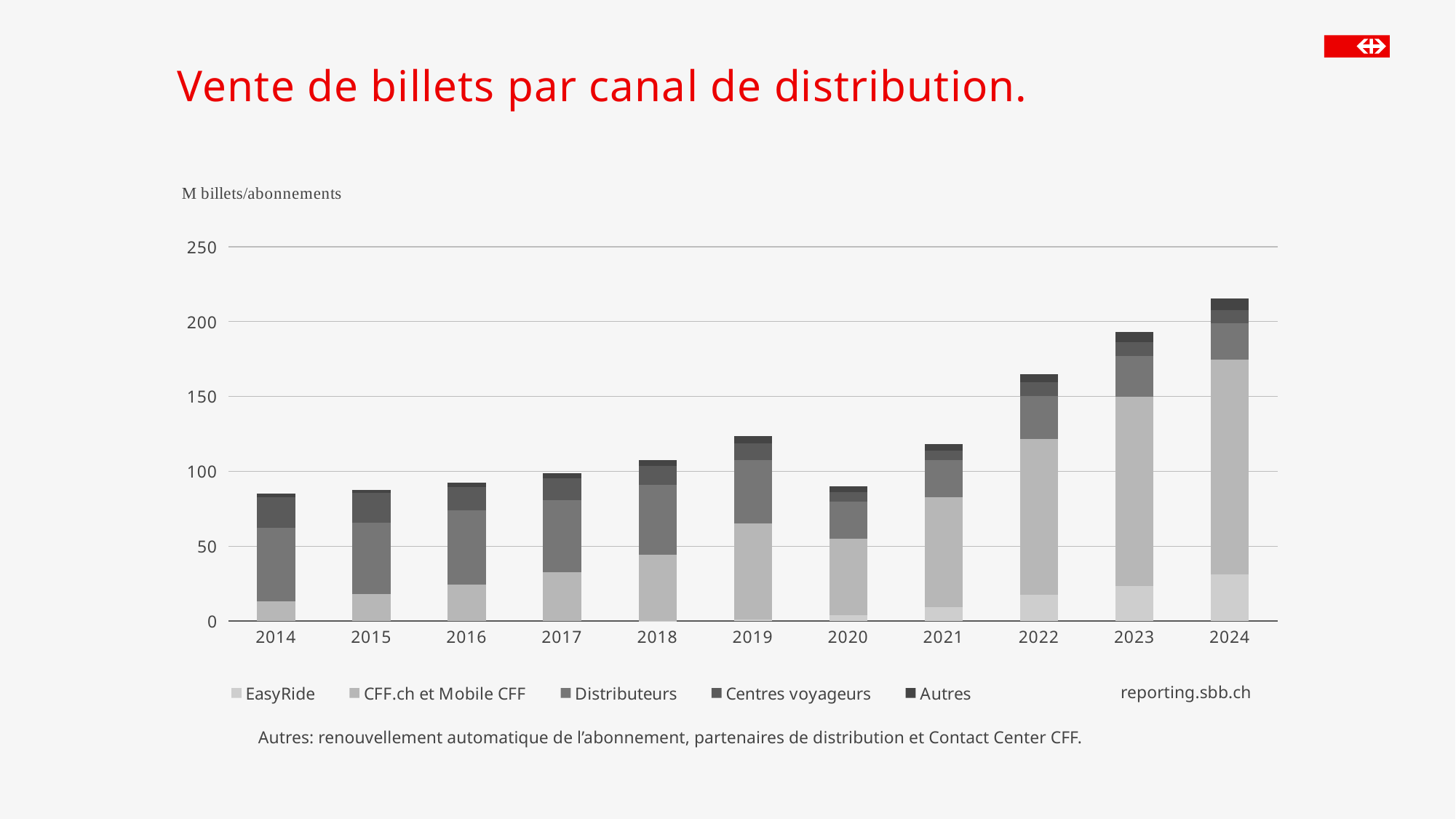
Which year has the larger total bar, 2019 or 2020? 2019 Do the total bar values rise or fall from 2014 to 2019? rise How many years are shown on the x axis of the chart? 11 Which year has the highest total bar in the chart? 2024 How many series does the chart legend list? 5 Is the total value for 2020 greater or less than 100? less What kind of chart is shown on the slide? Stacked bar chart Is the total value for 2024 greater or less than 200? greater What is the title of the chart on the slide? Vente de billets par canal de distribution. Is the total value for 2022 greater or less than 150? greater Which year has the larger total bar, 2022 or 2023? 2023